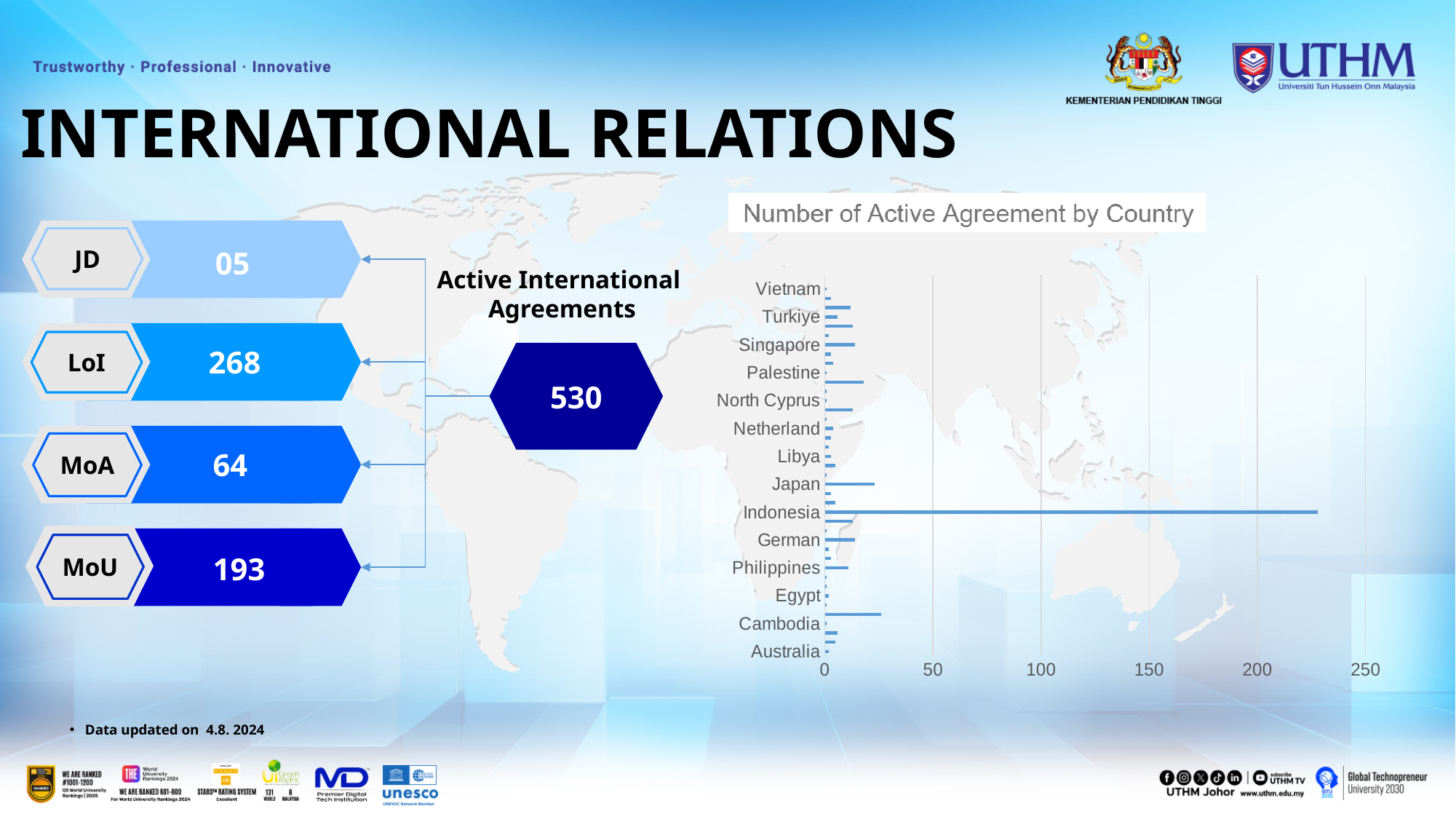
What is the title of the bar chart on the slide? Number of Active Agreement by Country In the "Number of Active Agreement by Country" chart, which has more active agreements, Japan or Netherland? Japan In the "Number of Active Agreement by Country" chart, is the value for Vietnam greater or less than 50? less What is the highest tick value shown on the horizontal axis of the "Number of Active Agreement by Country" chart? 250 In the "Number of Active Agreement by Country" chart, is the value for Cambodia greater or less than 50? less In the "Number of Active Agreement by Country" chart, which has more active agreements, Indonesia or Australia? Indonesia In the "Number of Active Agreement by Country" chart, is the value for Japan greater or less than 50? less In the "Number of Active Agreement by Country" chart, which has more active agreements, Indonesia or Japan? Indonesia In the "Number of Active Agreement by Country" chart, which country has the highest number of active agreements? Indonesia What kind of chart is "Number of Active Agreement by Country"? bar chart